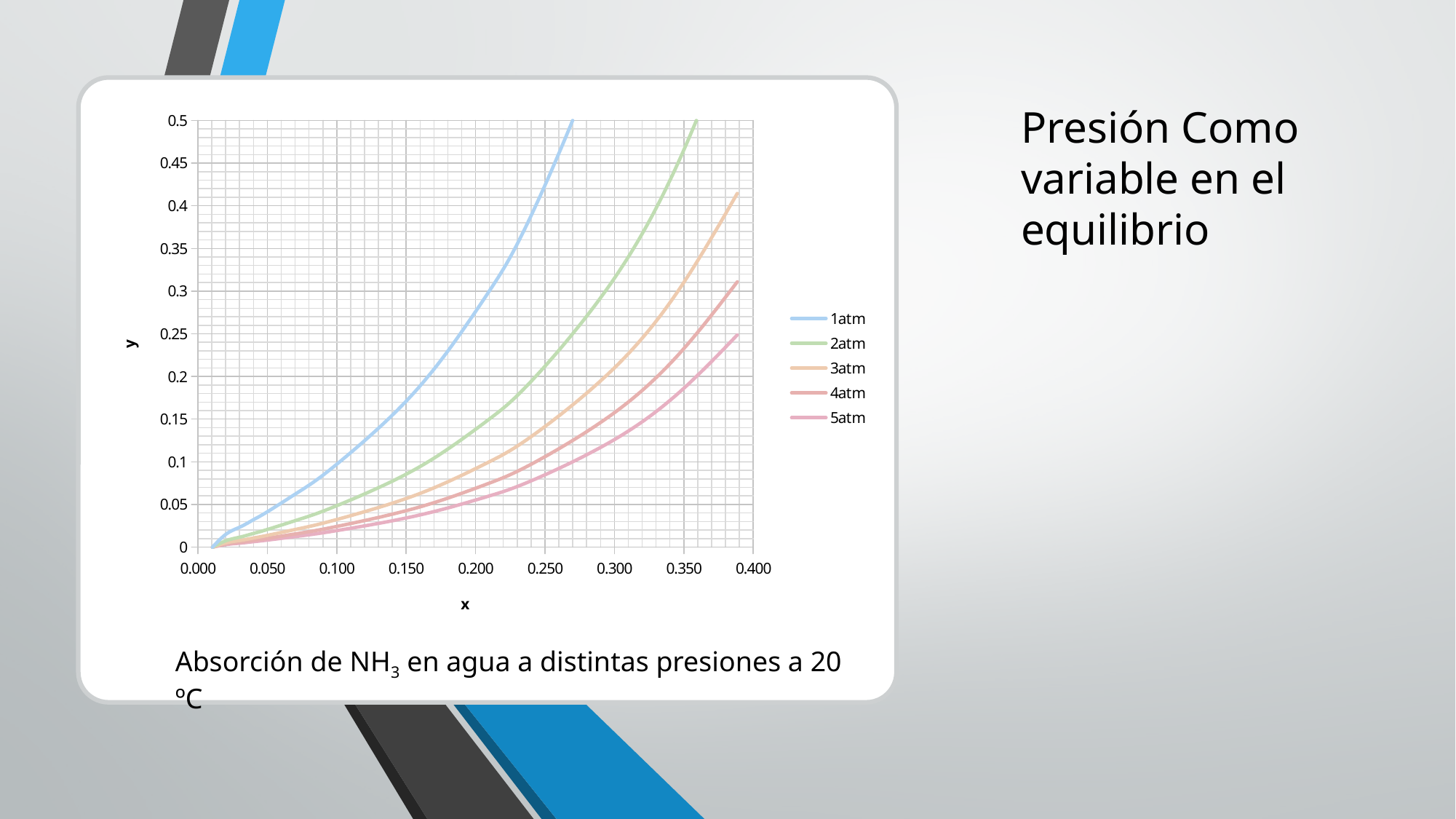
What are the series names listed in the legend? 1atm, 2atm, 3atm, 4atm, 5atm Is the y value of the 5atm series at x = 0.300 greater or less than 0.15? less Which series has the highest y value at x = 0.250? 1atm How many series does the legend list? 5 Is the y value of the 1atm series at x = 0.250 greater or less than 0.3? greater What is the label of the horizontal axis? x What kind of chart is shown on the slide? line chart Which series reaches y = 0.5 at the smallest x value? 1atm At x = 0.200, which series has the larger y value, 1atm or 5atm? 1atm Is the y value of the 2atm series at x = 0.300 greater or less than 0.2? greater Do the y values of the 1atm series rise or fall as x increases? rise Which series has the lowest y value at x = 0.300? 5atm